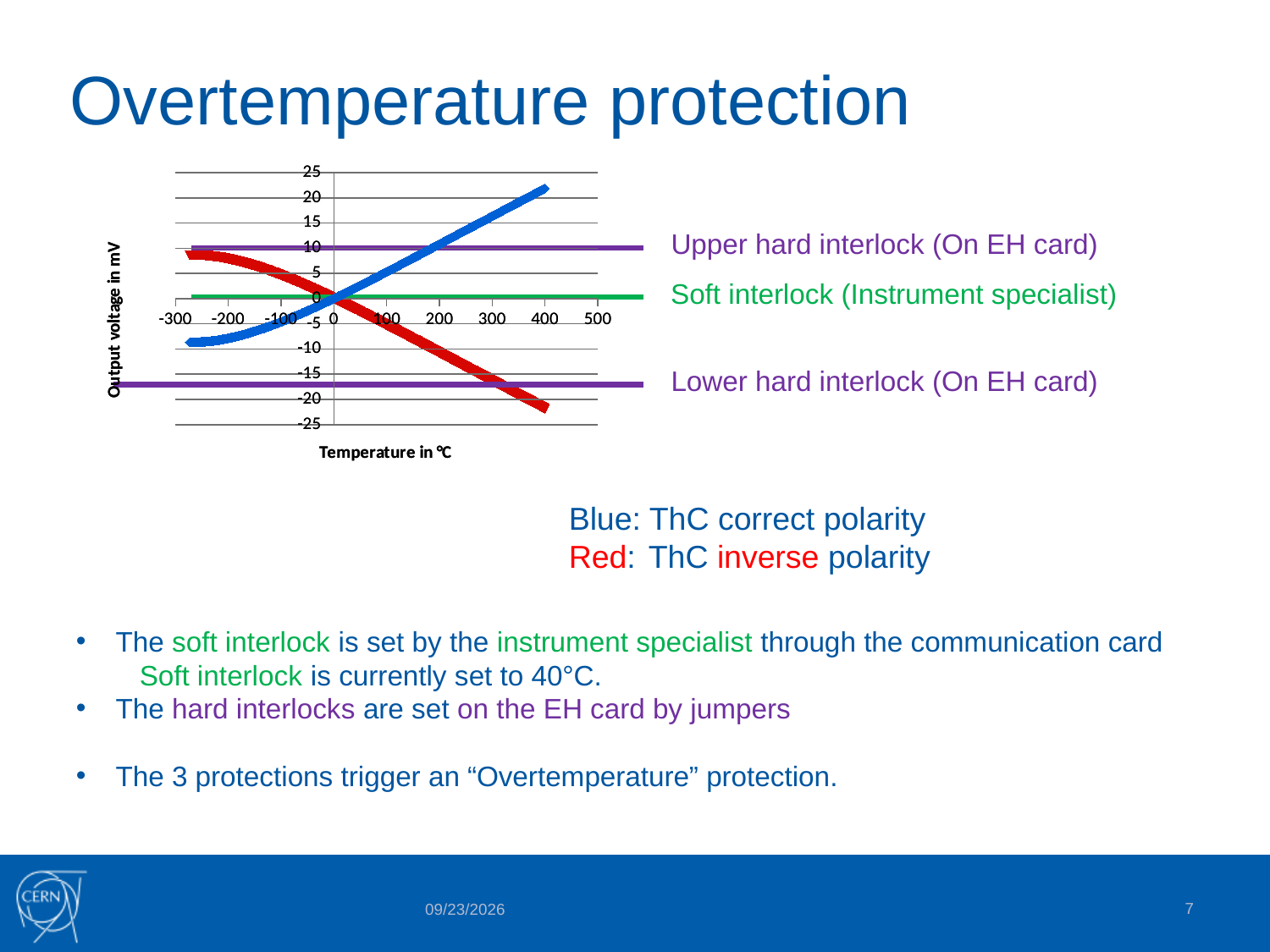
Does the blue curve (ThC correct polarity) rise or fall as temperature increases? rise What is the label of the x axis of the chart? Temperature in °C Does the red curve (ThC inverse polarity) rise or fall as temperature increases? fall How many thermocouple polarity curves are plotted on the chart? 2 What kind of chart is shown on the slide? line chart Is the value of the red curve at 400 °C greater or less than -15 mV? less What is the label of the y axis of the chart? Output voltage in mV At 300 °C, which curve has the higher output voltage, the blue one or the red one? blue At what output voltage (in mV) is the upper hard interlock line drawn? 10 Is the value of the blue curve at 400 °C greater or less than 15 mV? greater